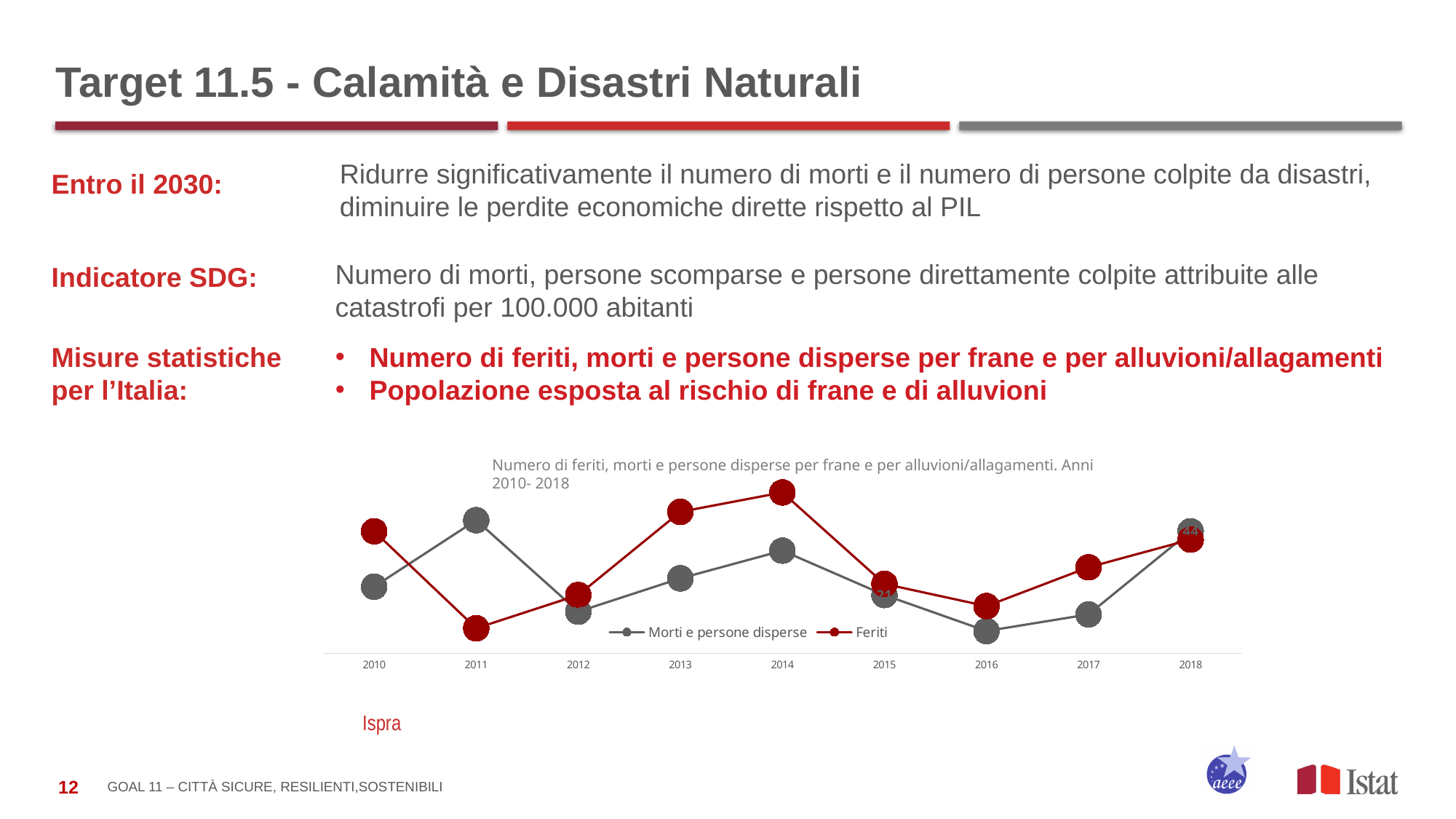
In which year does the 'Feriti' series reach its highest value? 2014 How many years are plotted along the x axis of the chart? 9 Does the 'Feriti' series rise or fall between 2011 and 2014? Rise What kind of chart is shown on the slide? Line chart In 2014, which series has the higher value: 'Morti e persone disperse' or 'Feriti'? Feriti In which year does the 'Feriti' series reach its lowest value? 2011 Does the 'Morti e persone disperse' series rise or fall between 2014 and 2016? Fall How many series does the chart legend list? 2 In which year does the 'Morti e persone disperse' series reach its lowest value? 2016 In 2010, which series has the higher value: 'Morti e persone disperse' or 'Feriti'? Feriti In 2011, which series has the higher value: 'Morti e persone disperse' or 'Feriti'? Morti e persone disperse Which colour is used for the 'Feriti' series in the chart? Red